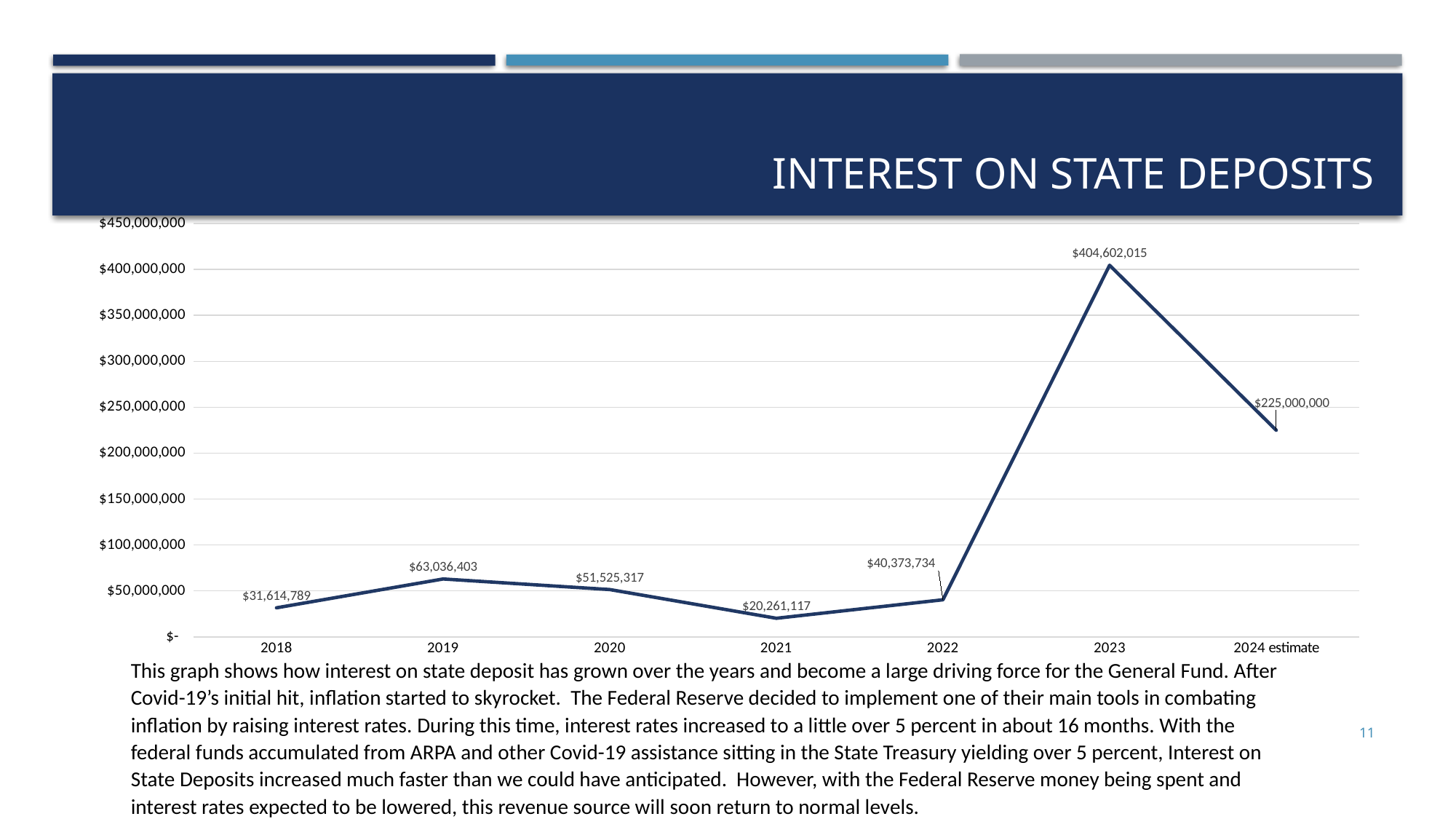
How many years are plotted on the x axis? 7 What is the value for the 2024 estimate? $225,000,000 Do the values rise or fall from 2019 to 2021? fall Is the value for 2023 greater or less than $400,000,000? greater Which year has the lowest value? 2021 What kind of chart is shown? line chart What is the value for 2018? $31,614,789 Which year has the highest value? 2023 What is the value for 2023? $404,602,015 What is the difference between the 2019 and 2018 values? $31,421,614 Which is larger, the value for 2020 or the value for 2022? 2020 What is the difference between the 2023 value and the 2024 estimate? $179,602,015